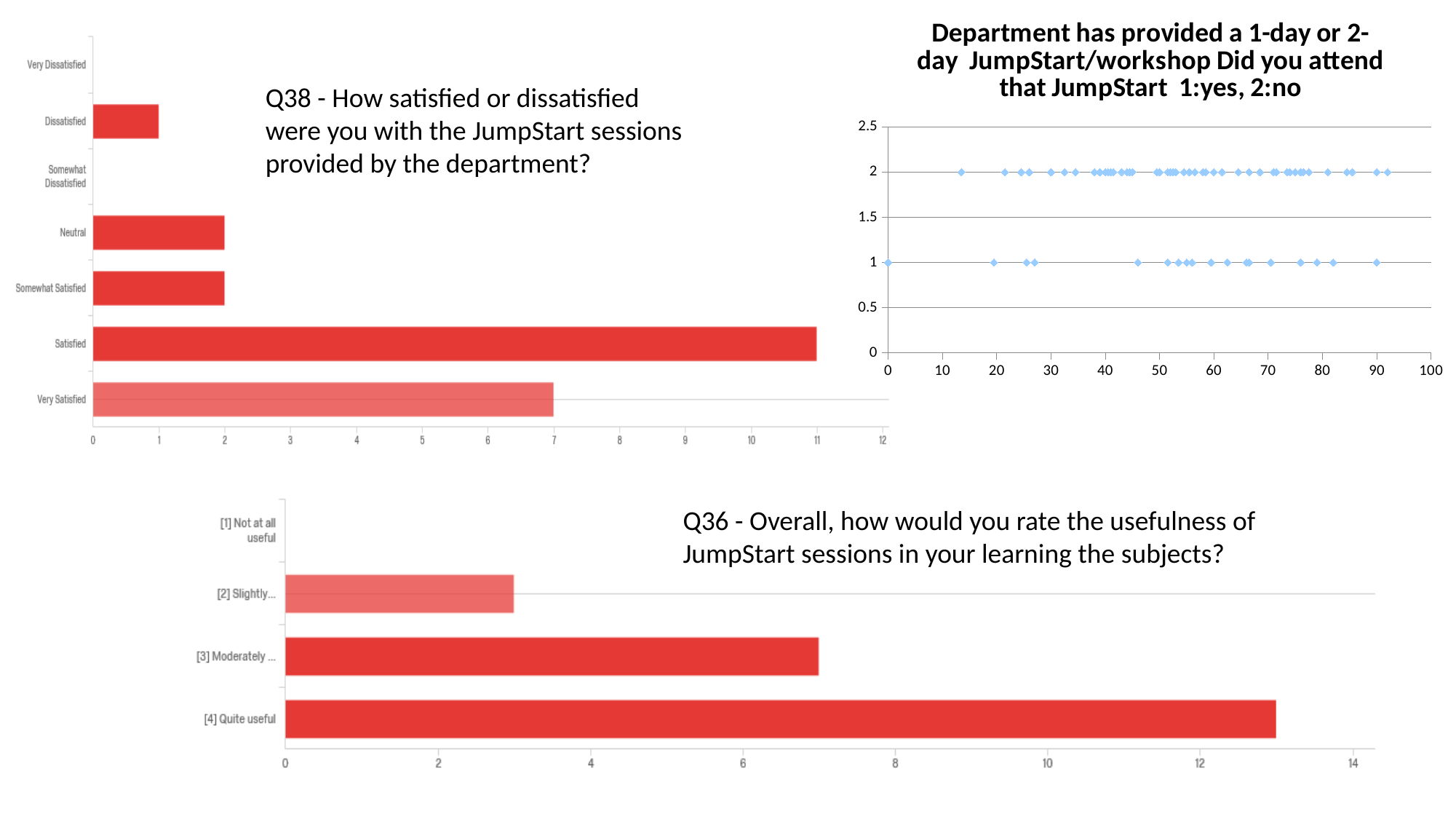
In the Q36 usefulness chart (bottom), is the value for [2] Slightly... greater or less than 4? less In the Q38 satisfaction chart (top left), which is larger, Neutral or Dissatisfied? Neutral In the Q38 satisfaction chart (top left), what is the value for Satisfied? 11 In the Q38 satisfaction chart (top left), what is the value for Dissatisfied? 1 In the Q38 satisfaction chart (top left), what is the difference between Satisfied and Very Satisfied? 4 In the Q36 usefulness chart (bottom), which category has the highest value? [4] Quite useful What kind of chart is the top-right chart titled 'Department has provided a 1-day or 2-day JumpStart/workshop'? scatter chart In the Q36 usefulness chart (bottom), is the value for [4] Quite useful greater or less than 12? greater In the Q38 satisfaction chart (top left), which category has the highest value? Satisfied What kind of chart is the Q36 usefulness chart at the bottom of the slide? bar chart In the Q38 satisfaction chart (top left), how many categories are listed on the vertical axis? 7 In the Q38 satisfaction chart (top left), what is the value for Very Satisfied? 7